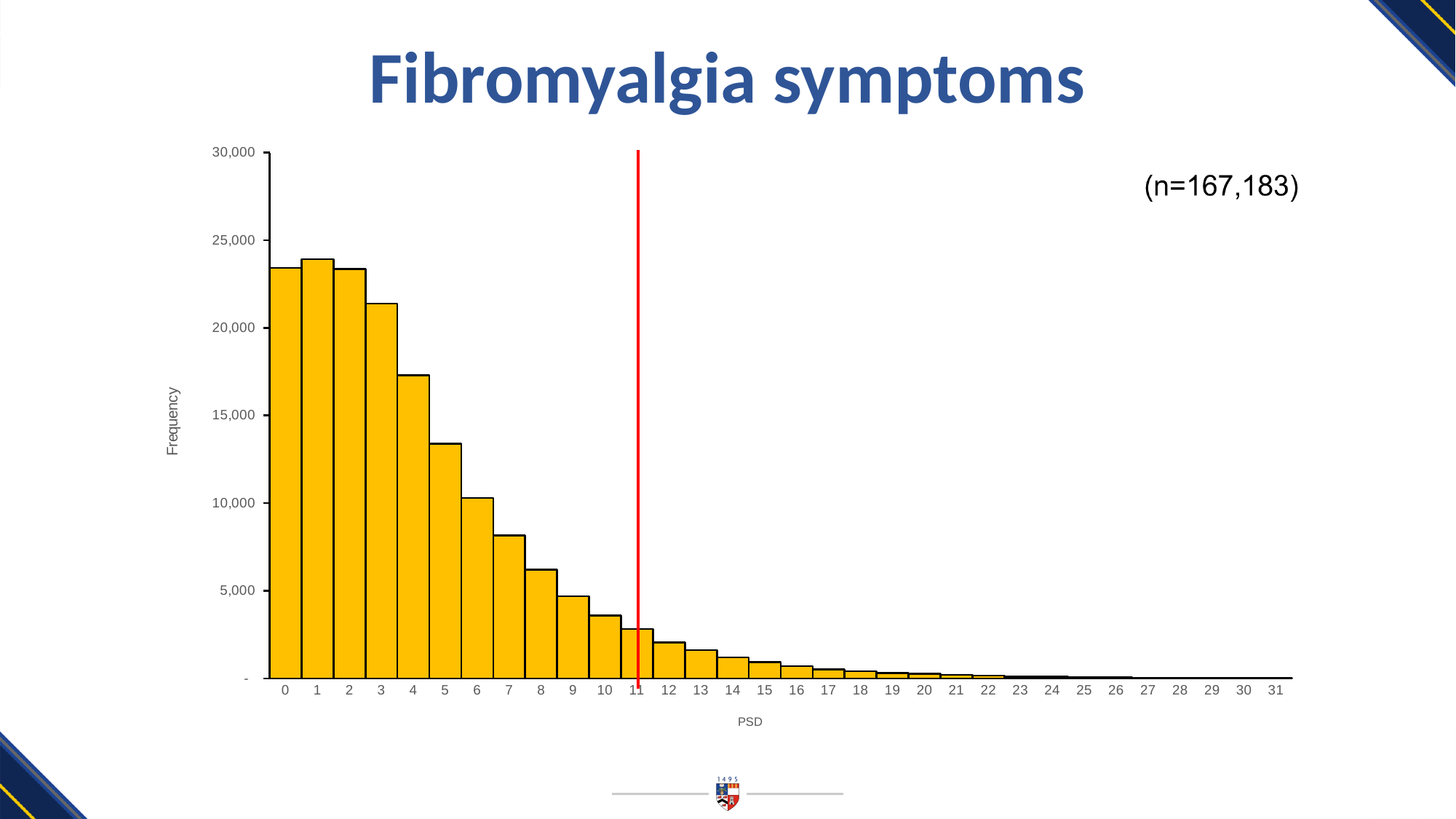
How many PSD categories are shown on the x axis? 32 Is the frequency for PSD 7 greater or less than 10,000? less Is the frequency for PSD 4 greater or less than 15,000? greater Which PSD value has the highest frequency? 1 What kind of chart is shown on the slide? Bar chart What is the label on the y axis? Frequency Which has the higher frequency, PSD 3 or PSD 4? PSD 3 Is the frequency for PSD 0 greater or less than 20,000? greater What sample size is stated on the slide? n=167,183 Do the frequencies generally rise or fall as PSD increases from 1 to 31? fall